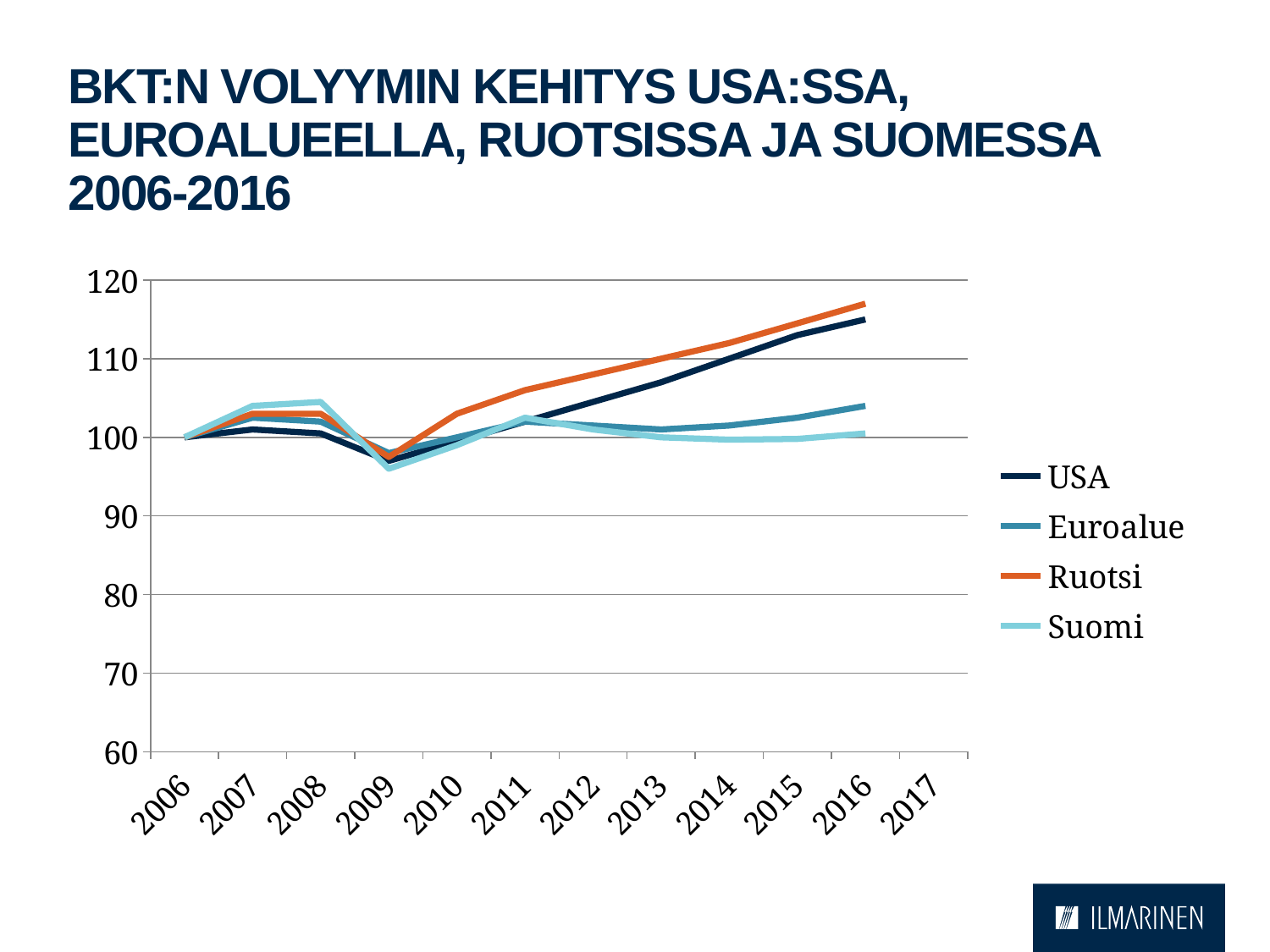
Is the value for Ruotsi in 2016 greater or less than 110? greater How many series does the legend list? 4 Which series are listed in the legend? USA, Euroalue, Ruotsi, Suomi Is the value for Suomi in 2009 greater or less than 100? less Which series has the lowest value in 2016? Suomi What kind of chart is shown on the slide? line chart Which series has the highest value in 2016? Ruotsi Is the value for Suomi in 2016 greater or less than 110? less Does the Ruotsi line rise or fall from 2009 to 2016? rise In 2016, which is larger: the value for USA or the value for Euroalue? USA What is the value for USA in 2006? 100